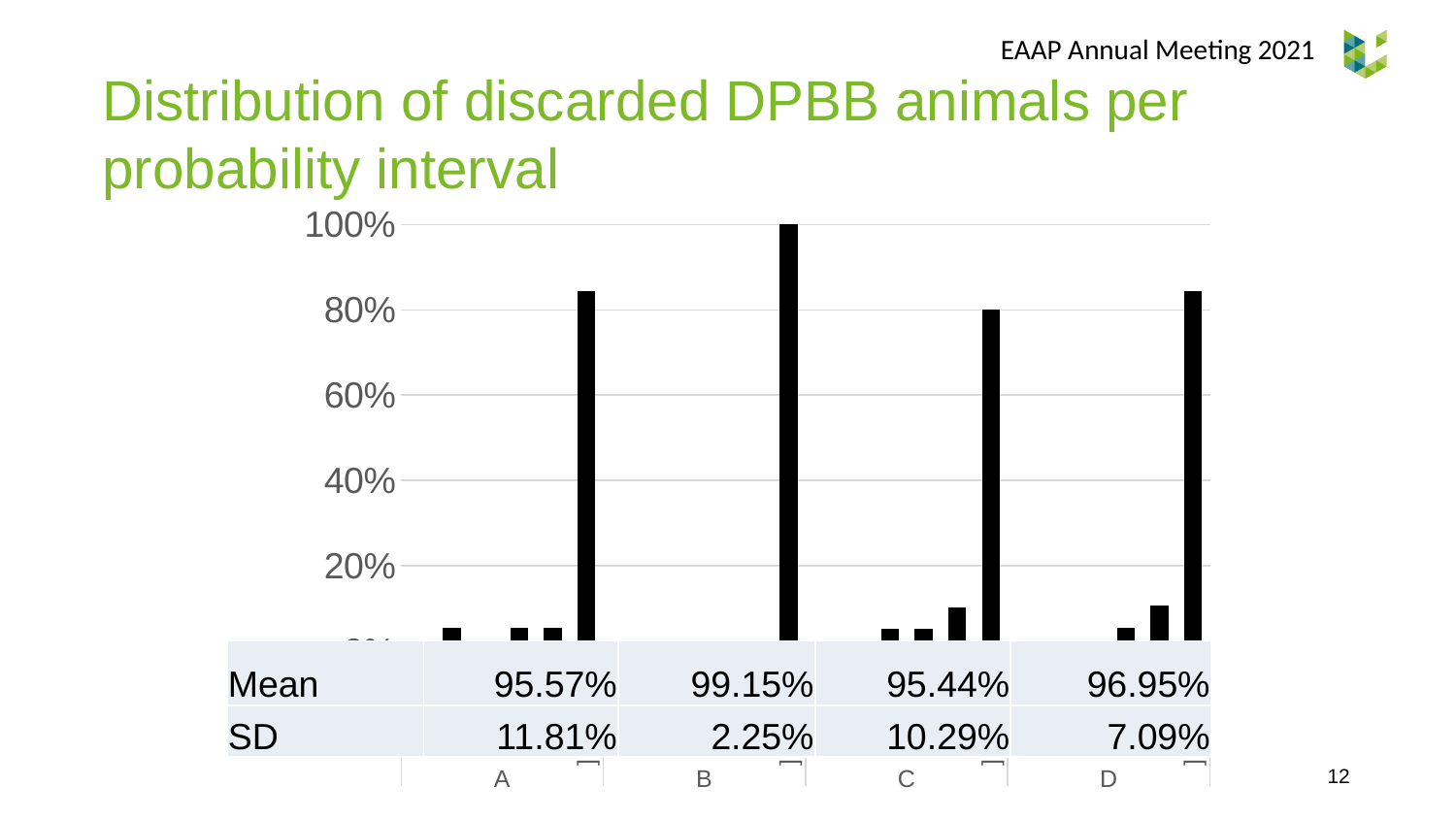
Which group has the highest SD value? A What is the Mean value shown for group B? 99.15% What is the difference between the SD of group A and the SD of group B? 9.56% What is the SD value shown for group A? 11.81% Which group has the lowest SD value? B Which group has the highest Mean value? B What is the Mean value shown for group D? 96.95% Is the tallest bar in group B greater or less than 80%? greater What kind of chart is shown on the slide? bar chart What is the title of the chart on the slide? Distribution of discarded DPBB animals per probability interval Is the Mean of group C larger or smaller than the Mean of group D? smaller How many groups (A, B, C, D) are shown along the x axis of the chart? 4